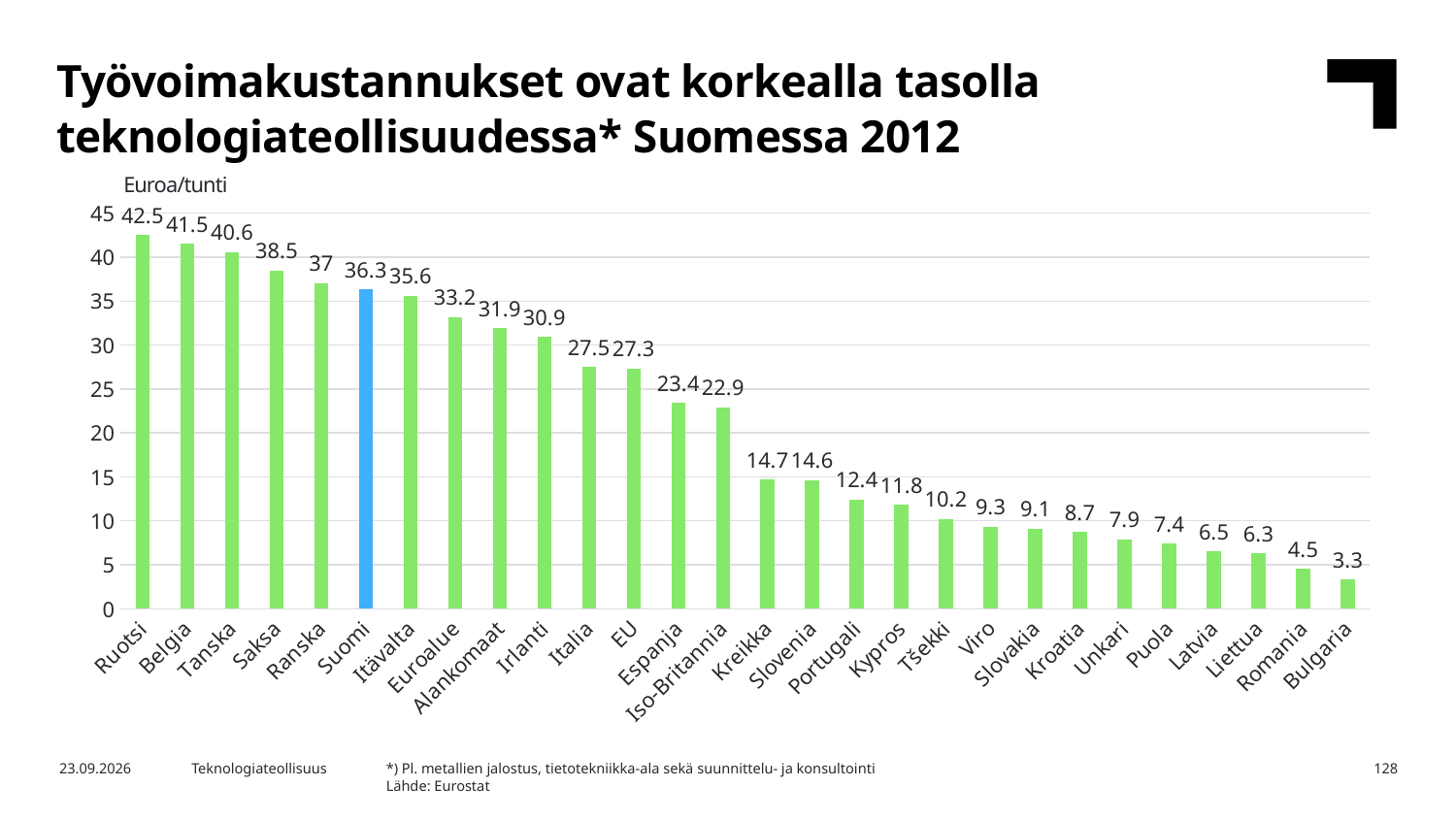
Do the values rise or fall from left to right along the x axis? Fall What kind of chart is shown on the slide? Bar chart How many countries or regions are shown on the chart? 28 Which bar is coloured blue instead of green? Suomi What is the difference between the values for Ruotsi and Suomi? 6.2 Which country has the lowest labour cost per hour? Bulgaria Which is larger, the value for Saksa or the value for Ranska? Saksa What is the value for Viro? 9.3 What is the value for Suomi? 36.3 Which country has the highest labour cost per hour? Ruotsi What is the value for EU? 27.3 What is the difference between the values for Suomi and EU? 9